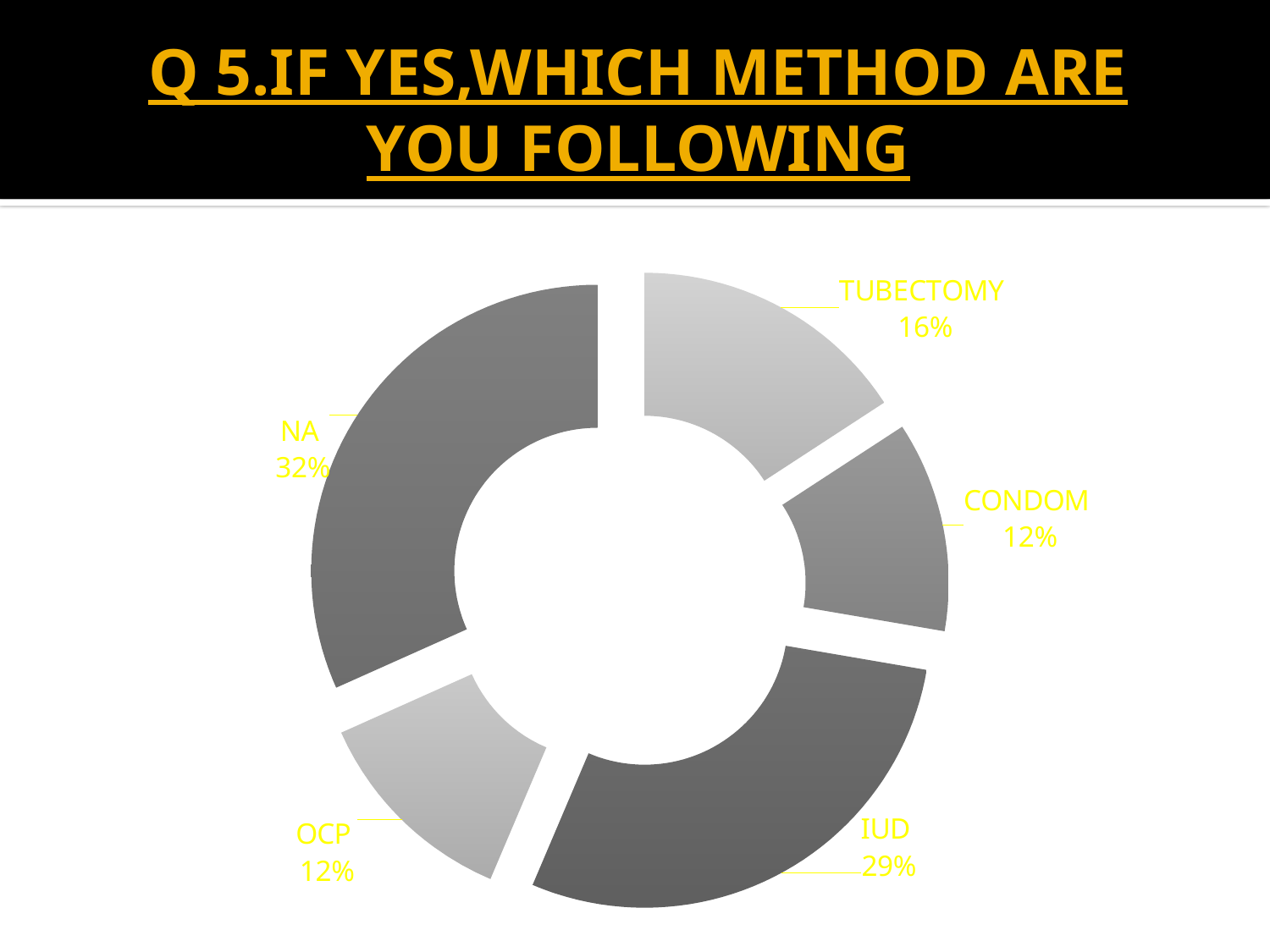
What share of the chart does OCP represent? 12% What kind of chart is shown on the slide? Doughnut chart What is the difference in percentage points between IUD and TUBECTOMY? 13 What is the title of the chart on the slide? Q 5.IF YES,WHICH METHOD ARE YOU FOLLOWING What is the difference in percentage points between NA and IUD? 3 What share of the chart does NA represent? 32% What share of the chart does IUD represent? 29% Which category has the largest share? NA What share of the chart does TUBECTOMY represent? 16% What share of the chart does CONDOM represent? 12% How many categories are shown in the chart? 5 Which is larger, the share for TUBECTOMY or the share for CONDOM? TUBECTOMY